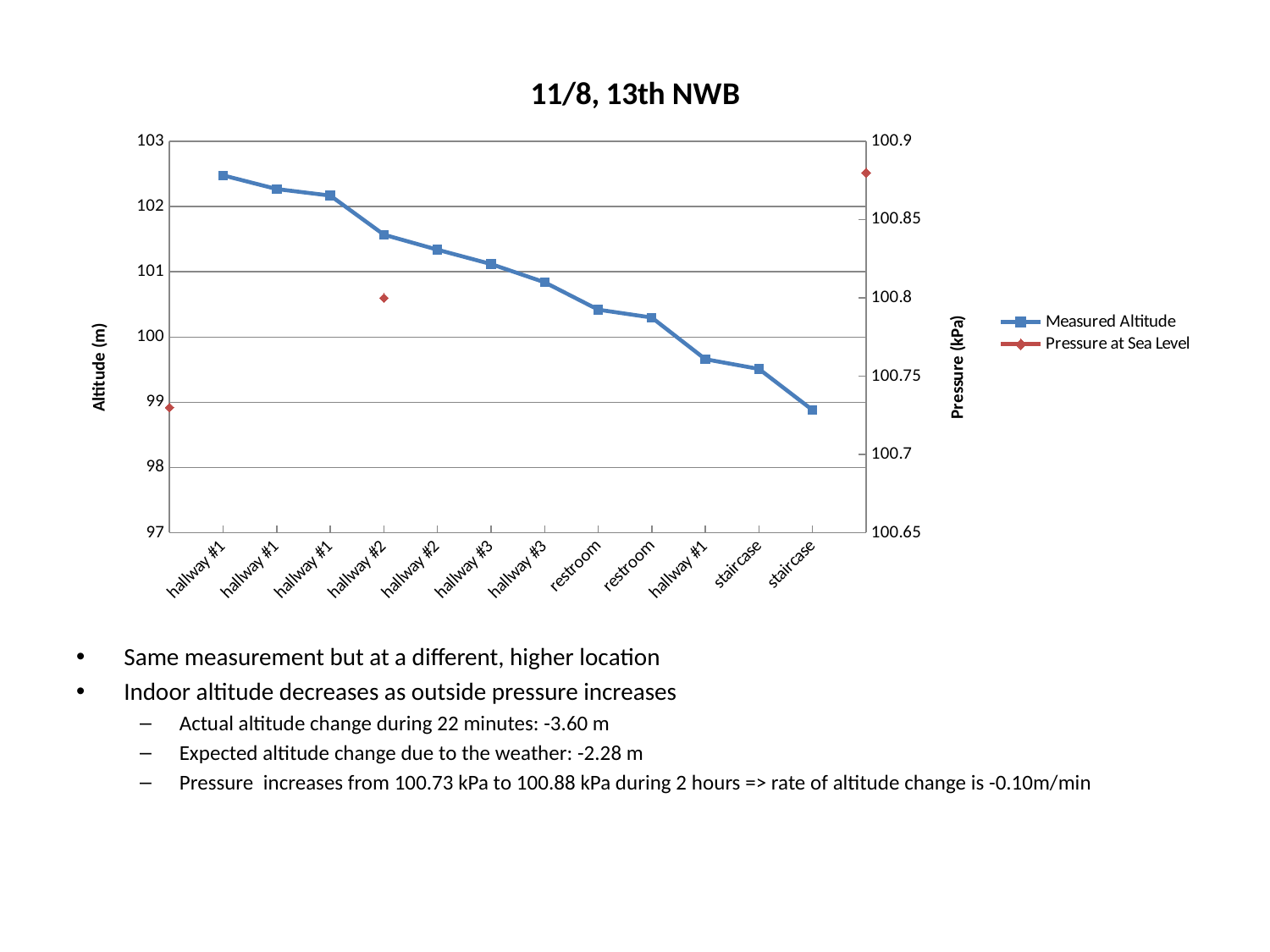
Is the Measured Altitude at the first restroom point greater or less than 100? greater Which x-axis category has the lowest Measured Altitude? staircase (the last point) What is the label of the right-hand vertical axis? Pressure (kPa) What is the title of the chart? 11/8, 13th NWB Is the Measured Altitude at the first hallway #1 point greater or less than 102? greater Does the Measured Altitude rise or fall along the x axis? fall What kind of chart is shown on the slide? line chart Is the Measured Altitude at the last staircase point greater or less than 100? less How many series does the legend list? 2 How many points are plotted for the Measured Altitude series? 12